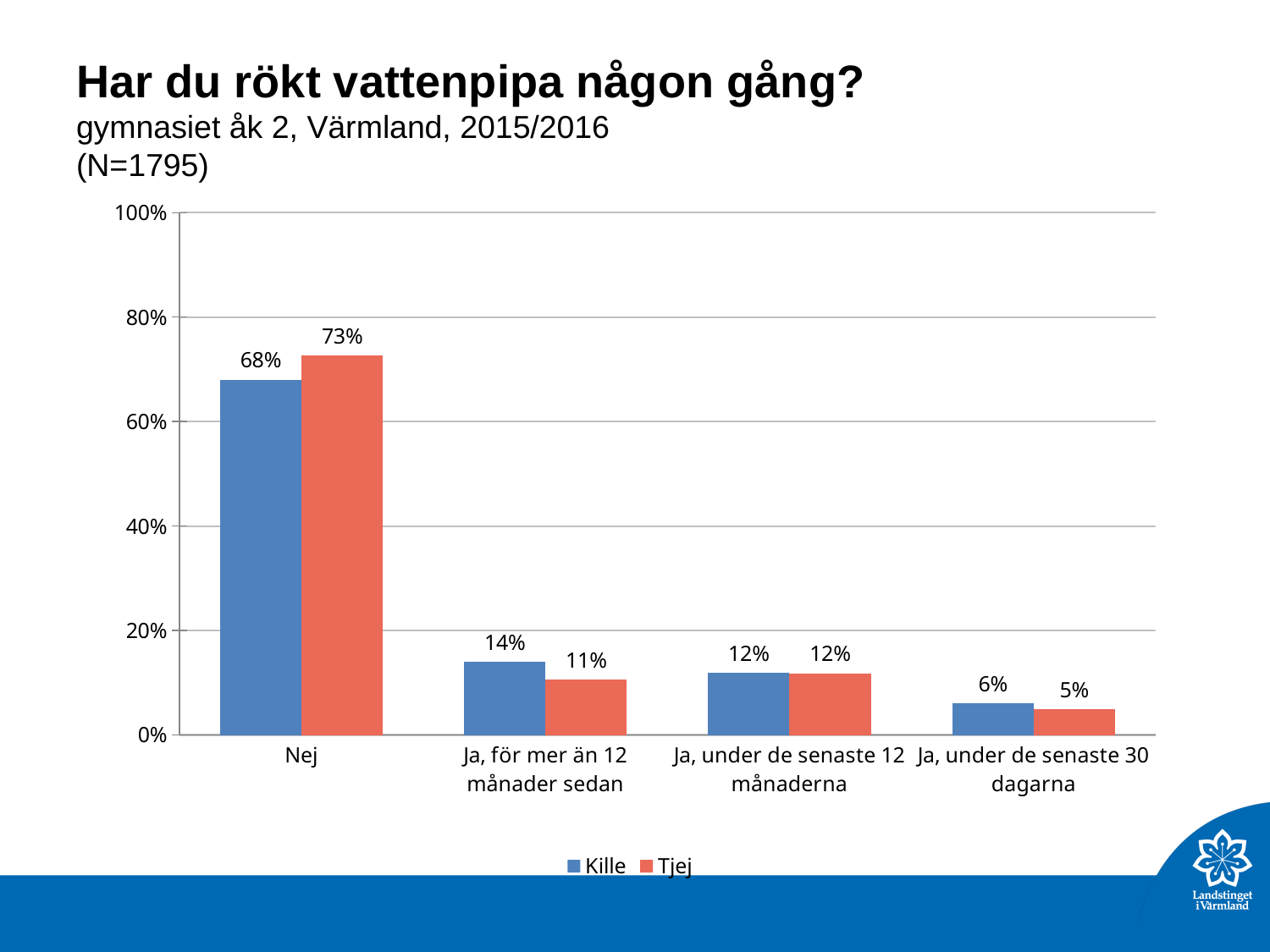
What is the value for Kille in the category 'Ja, under de senaste 30 dagarna'? 6% What is the difference between the Tjej and Kille values in the Nej category? 5% Which category has the highest value for Tjej? Nej What is the sample size (N) stated in the chart title? 1795 What is the value for Tjej in the Nej category? 73% How many categories are shown on the x axis? 4 Which category has the lowest value for Kille? Ja, under de senaste 30 dagarna What kind of chart is shown on the slide? Bar chart In the category 'Ja, för mer än 12 månader sedan', which is larger, Kille or Tjej? Kille What is the value for Kille in the Nej category? 68% How many series does the legend list? 2 What is the value for Tjej in the category 'Ja, för mer än 12 månader sedan'? 11%